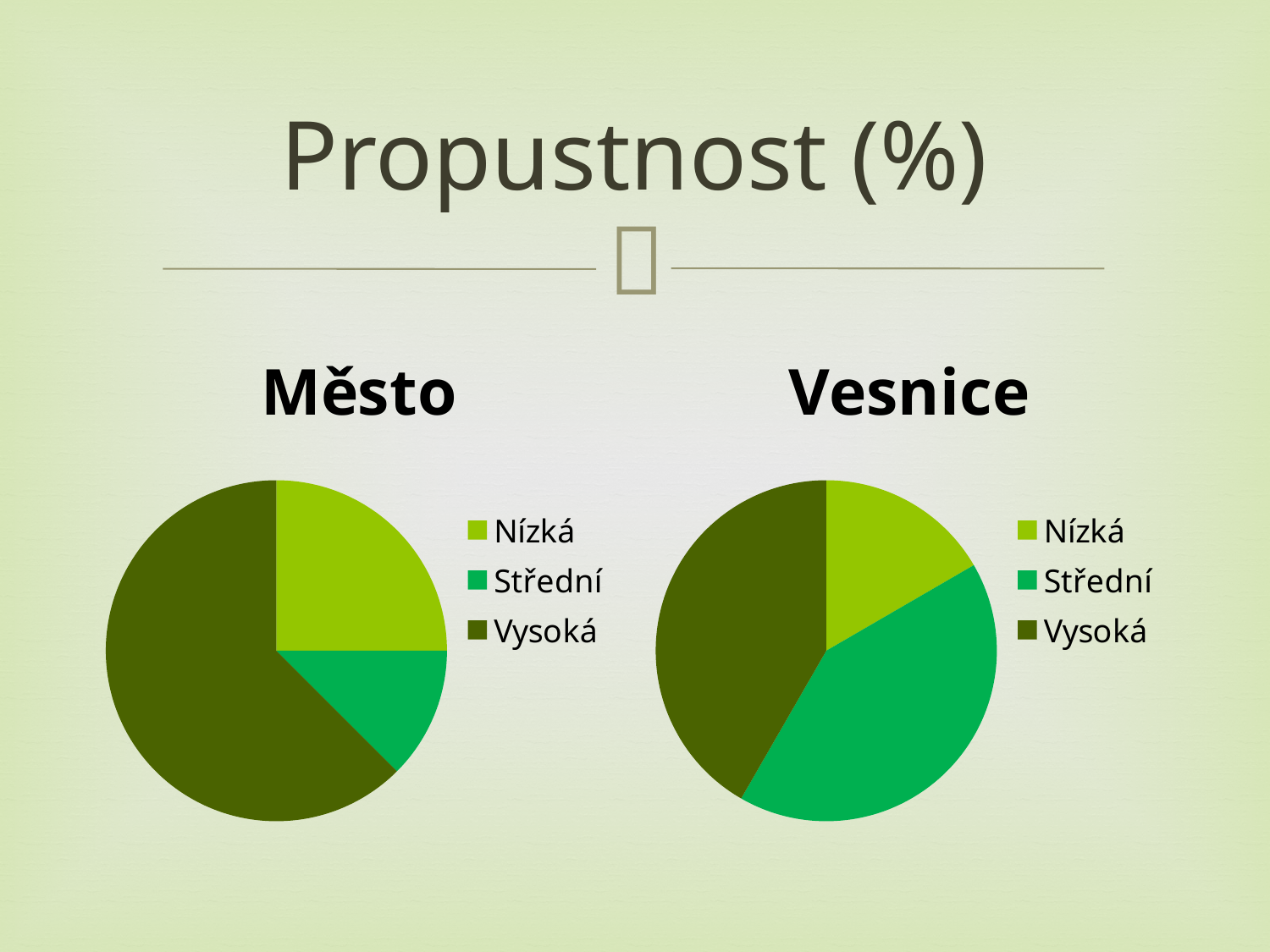
In the Město pie chart, which category has the largest slice? Vysoká In the Vesnice pie chart, which category has the smallest slice? Nízká What kind of chart is used under the heading Město? Pie chart In the Město pie chart, which slice is larger, Nízká or Střední? Nízká What kind of chart is used under the heading Vesnice? Pie chart In the Vesnice pie chart, which slice is larger, Střední or Nízká? Střední In the Vesnice pie chart, which category is shown in the darkest green? Vysoká In the Město pie chart, which category has the smallest slice? Střední What is the title of the slide containing the two pie charts? Propustnost (%) How many entries does the legend of the Město pie chart list? 3 How many slices does the Vesnice pie chart have? 3 How many slices does the Město pie chart have? 3